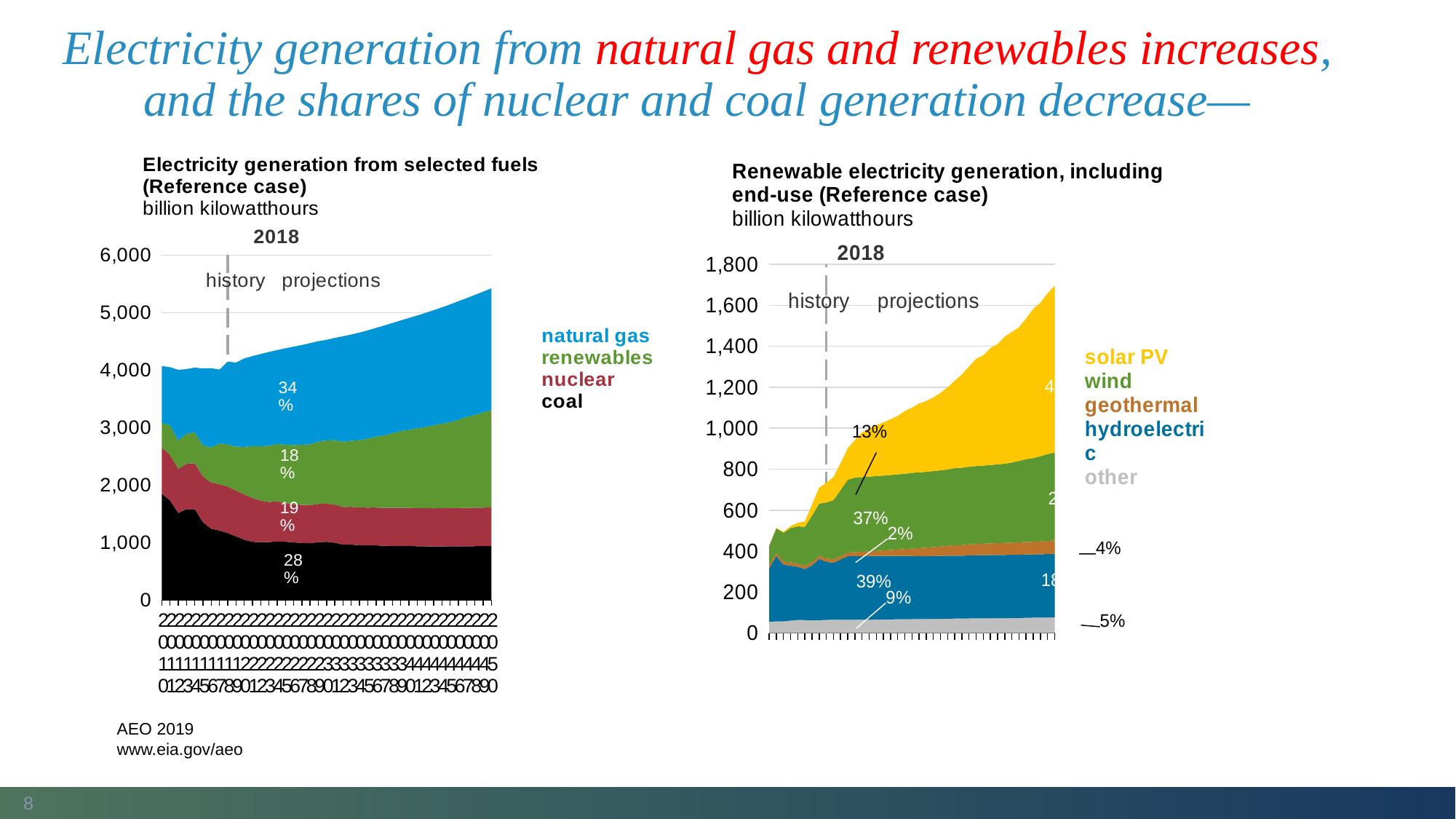
In the left chart, 'Electricity generation from selected fuels', is the total generation in 2050 greater or less than 5,000 billion kilowatthours? greater In the right chart, 'Renewable electricity generation, including end-use', is total renewable generation in 2050 greater or less than 1,400 billion kilowatthours? greater In the right chart, 'Renewable electricity generation, including end-use', which source has the smallest labelled share at 2018? geothermal What kind of chart is the 'Electricity generation from selected fuels' chart on the left? stacked area chart In the left chart, 'Electricity generation from selected fuels', what share is labelled for coal at 2018? 28% How many series does the legend of the right chart, 'Renewable electricity generation, including end-use', list? 5 In the left chart, 'Electricity generation from selected fuels', which fuel has the largest labelled share at 2018? natural gas In the right chart, 'Renewable electricity generation, including end-use', what share is labelled for wind at 2018? 37% In the left chart, 'Electricity generation from selected fuels', what share is labelled for natural gas at 2018? 34% How many series does the legend of the left chart, 'Electricity generation from selected fuels', list? 4 In the left chart, 'Electricity generation from selected fuels', does coal generation rise or fall from 2010 to 2050? fall In the left chart, 'Electricity generation from selected fuels', what is the difference between the labelled 2018 shares of natural gas and coal? 6 percentage points